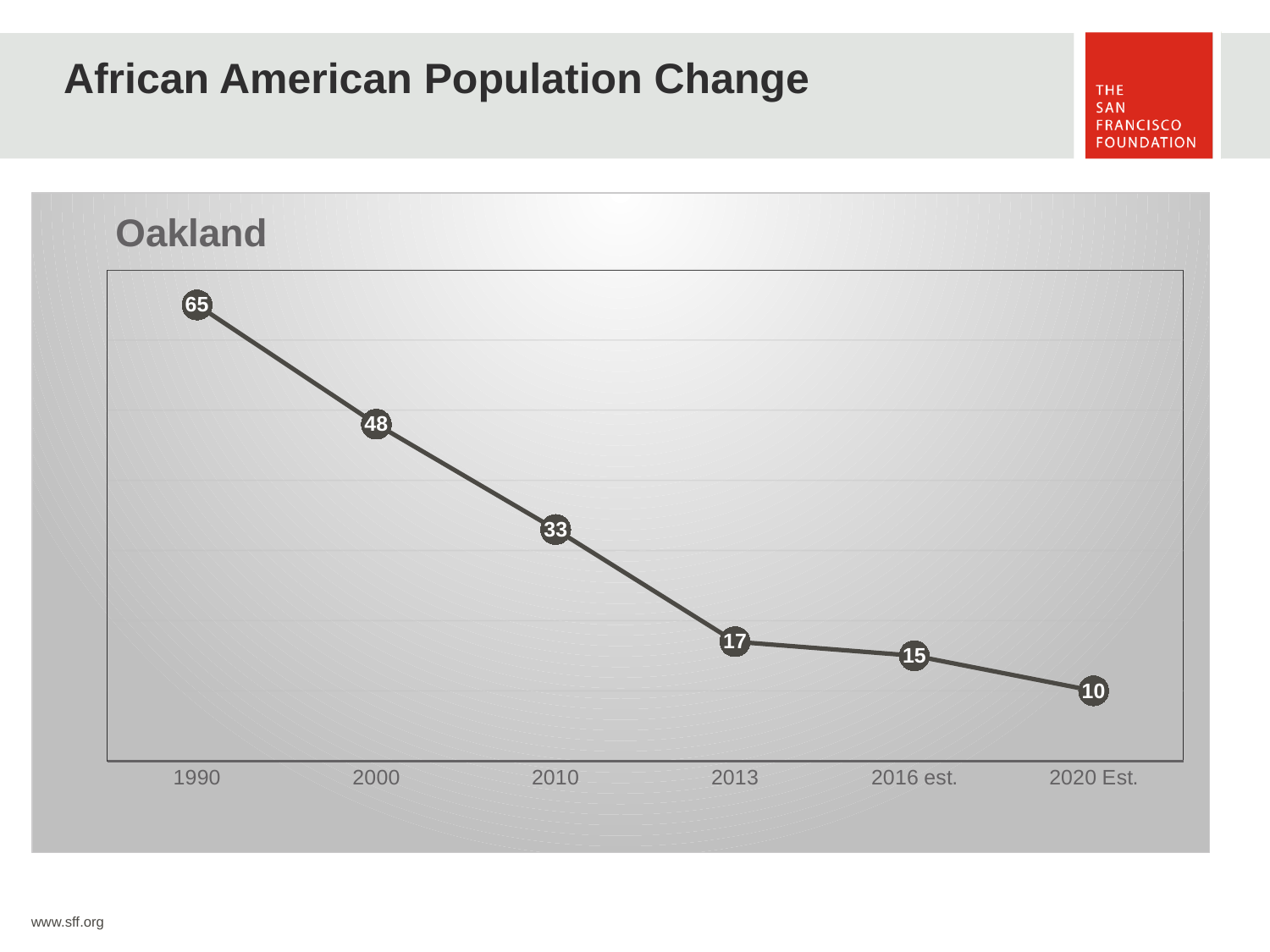
What is the value for 2020 Est.? 10 Which year has the lowest value? 2020 Est. What is the difference between the values for 1990 and 2000? 17 What is the value for 1990? 65 Which year has the highest value? 1990 What is the difference between the values for 2010 and 2013? 16 What is the value for 2016 est.? 15 Which is larger, the value for 2013 or the value for 2016 est.? 2013 How many data points are plotted on the chart? 6 Do the values rise or fall from 1990 to 2020 Est.? fall What kind of chart is shown? line chart What is the value for 2010? 33